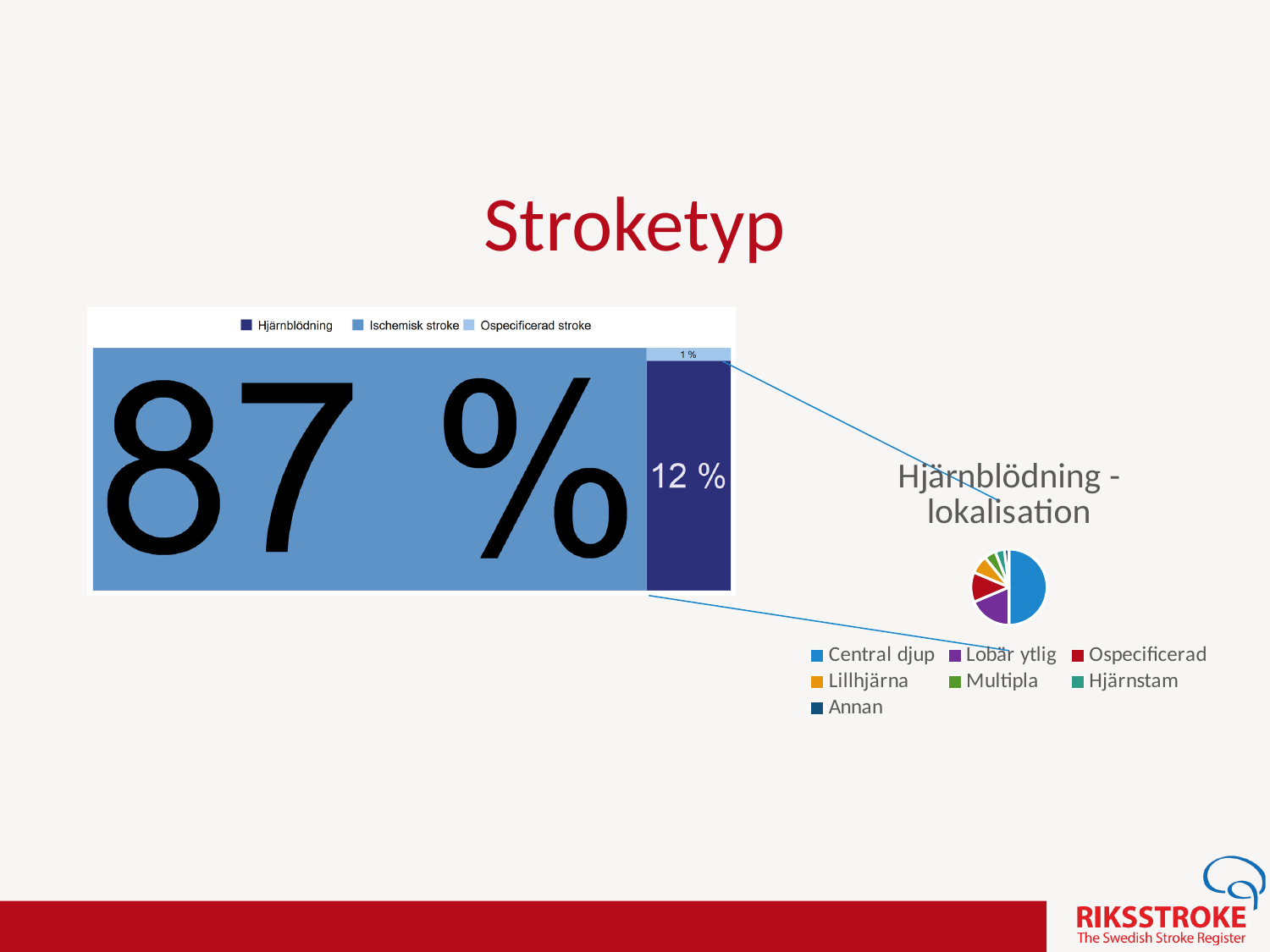
In the Stroketyp chart, which is larger: Hjärnblödning or Ospecificerad stroke? Hjärnblödning In the Stroketyp chart, what percentage is shown for Ischemisk stroke? 87 % In the 'Hjärnblödning - lokalisation' pie chart, which category has the largest slice? Central djup How many entries does the legend of the Stroketyp chart list? 3 In the Stroketyp chart, what percentage is shown for Ospecificerad stroke? 1 % What kind of chart is the 'Hjärnblödning - lokalisation' chart? Pie chart In the Stroketyp chart, what percentage is shown for Hjärnblödning? 12 % In the Stroketyp chart, what is the difference in percentage points between Ischemisk stroke and Hjärnblödning? 75 In the Stroketyp chart, which stroke type has the smallest share? Ospecificerad stroke How many categories does the legend of the 'Hjärnblödning - lokalisation' pie chart list? 7 In the Stroketyp chart, which stroke type has the largest share? Ischemisk stroke In the Stroketyp chart, what is the total of the three percentages shown? 100 %